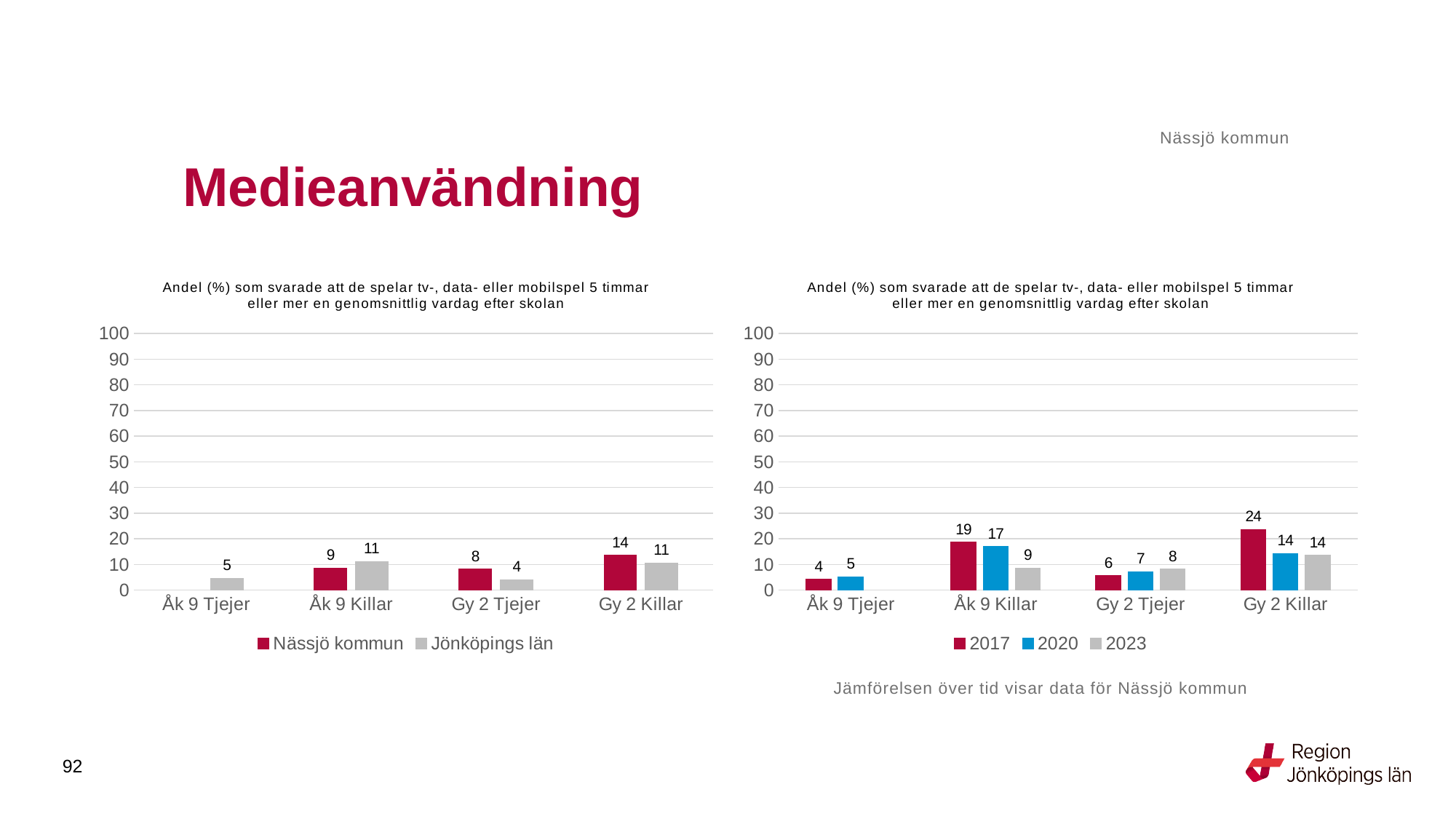
In the left chart, which category has the highest value for Nässjö kommun? Gy 2 Killar In the left chart, what is the difference between Nässjö kommun and Jönköpings län for Gy 2 Tjejer? 4 In the right chart, do the values for Gy 2 Tjejer rise or fall from 2017 to 2023? rise What kind of chart is the right chart? bar chart In the left chart, what is the value for Jönköpings län for Gy 2 Killar? 11 In the right chart, what is the value for 2023 for Åk 9 Killar? 9 How many series does the legend of the left chart list? 2 How many series does the legend of the right chart list? 3 In the right chart, what is the difference between 2017 and 2023 for Åk 9 Killar? 10 In the left chart, what is the value for Nässjö kommun for Gy 2 Tjejer? 8 In the right chart, what is the value for 2017 for Gy 2 Killar? 24 In the left chart, which is larger for Åk 9 Killar: Nässjö kommun or Jönköpings län? Jönköpings län